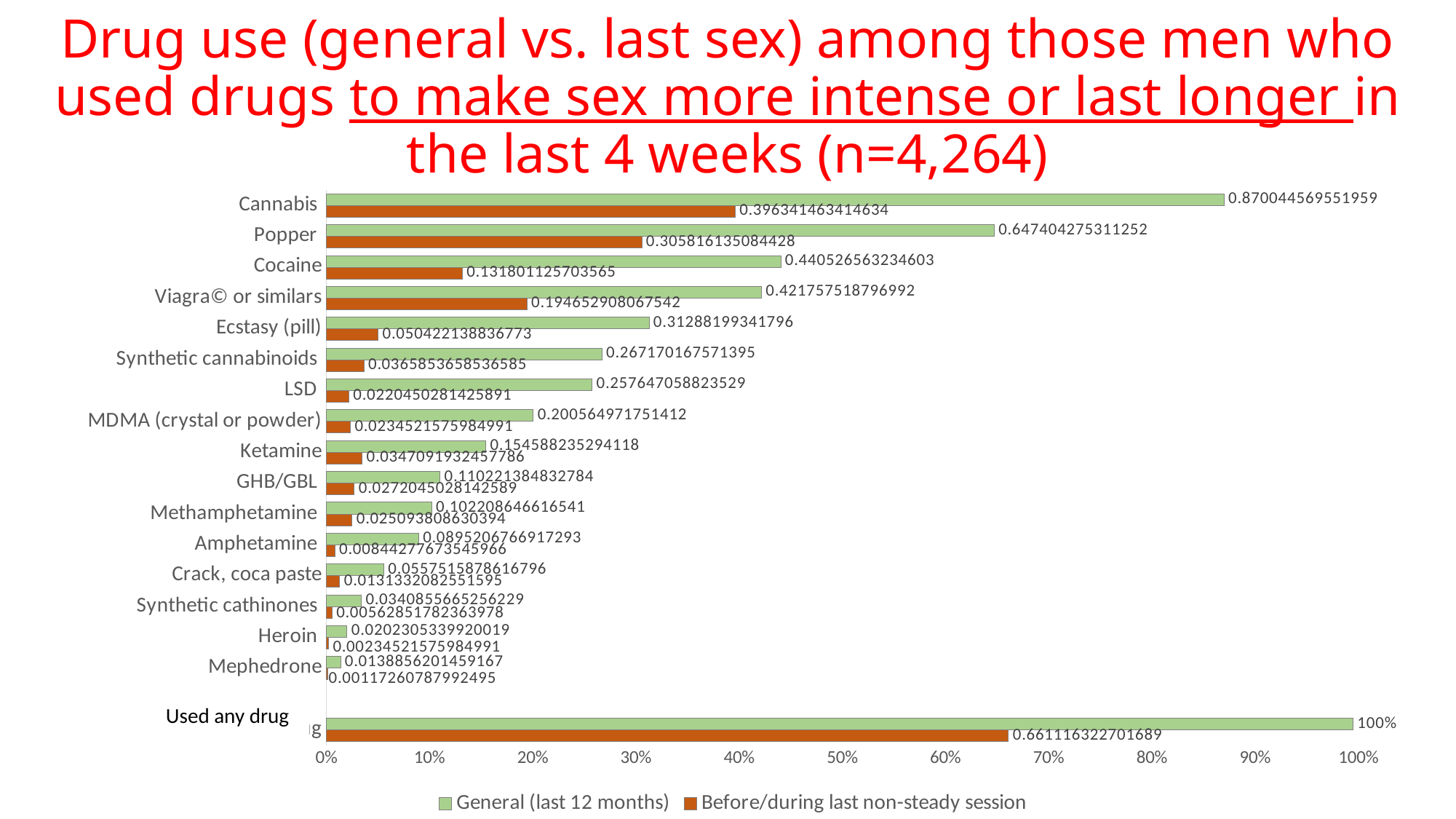
What is the data label for Used any drug in the General (last 12 months) series? 100% What is the data label for Used any drug in the Before/during last non-steady session series? 0.661116322701689 How many series does the legend list? 2 What is the data label for Popper in the Before/during last non-steady session series? 0.305816135084428 What kind of chart is shown on the slide? bar chart Excluding Used any drug, which drug has the highest value in the General (last 12 months) series? Cannabis What is the data label for Cannabis in the General (last 12 months) series? 0.870044569551959 Is the General (last 12 months) value for Ecstasy (pill) greater or less than 30%? greater Is the Before/during last non-steady session value for Cannabis greater or less than 40%? less What are the two legend entries of the chart? General (last 12 months); Before/during last non-steady session Which is larger: the General (last 12 months) value for Cocaine or for Viagra© or similars? Cocaine Which drug has the lowest value in the Before/during last non-steady session series? Mephedrone